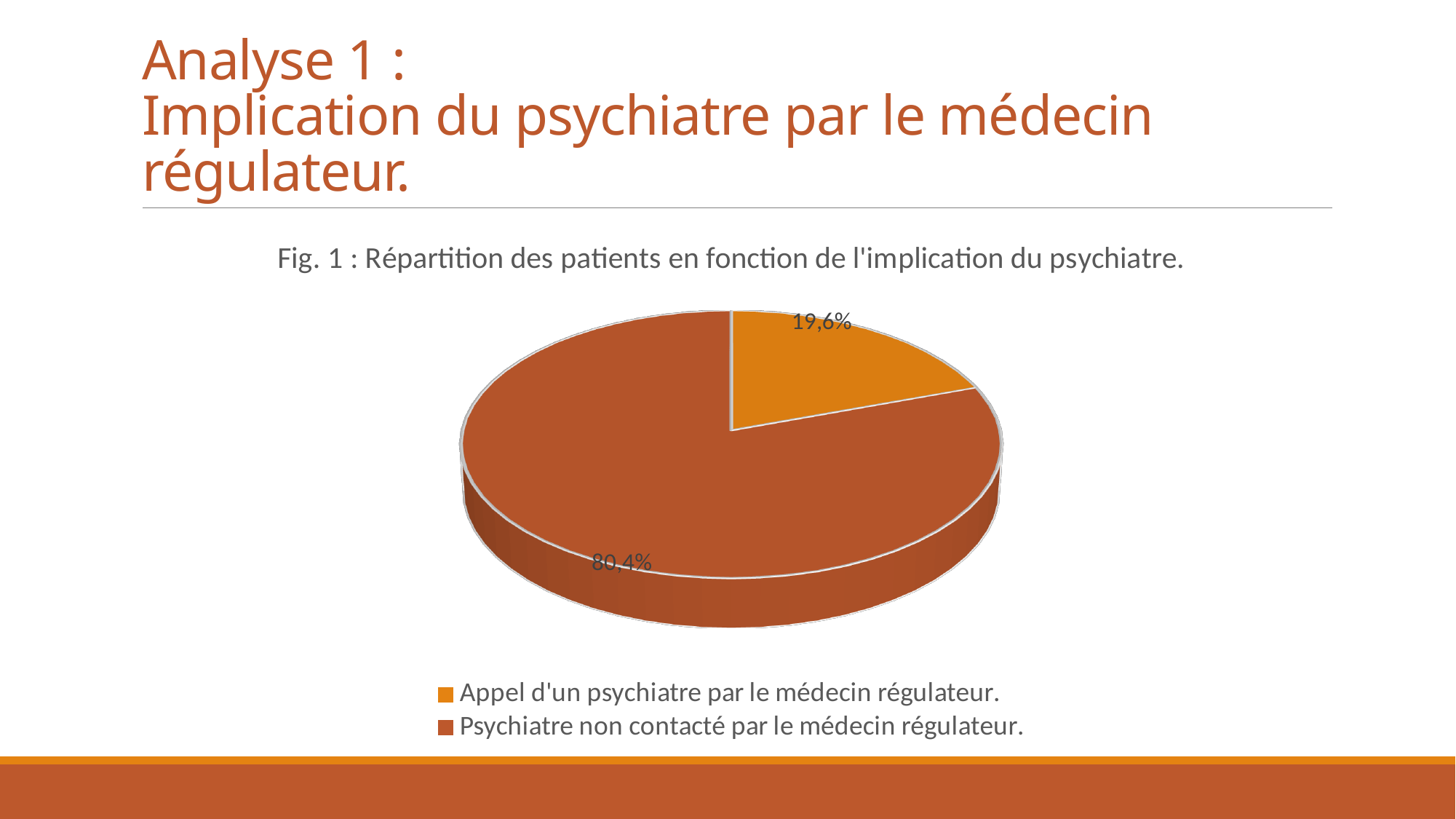
How many entries does the legend list? 2 Which category has the smallest share of the pie? Appel d'un psychiatre par le médecin régulateur. What kind of chart is shown on the slide? pie chart What is the difference in percentage points between the two slices of the pie? 60,8 Which is larger: the share for "Appel d'un psychiatre par le médecin régulateur." or the share for "Psychiatre non contacté par le médecin régulateur."? Psychiatre non contacté par le médecin régulateur. Which colour represents "Appel d'un psychiatre par le médecin régulateur." in the pie chart? orange What share of patients corresponds to "Psychiatre non contacté par le médecin régulateur."? 80,4% What is the title of the chart? Fig. 1 : Répartition des patients en fonction de l'implication du psychiatre. Which category has the largest share of the pie? Psychiatre non contacté par le médecin régulateur. What share of patients corresponds to "Appel d'un psychiatre par le médecin régulateur."? 19,6% How many slices does the pie chart have? 2